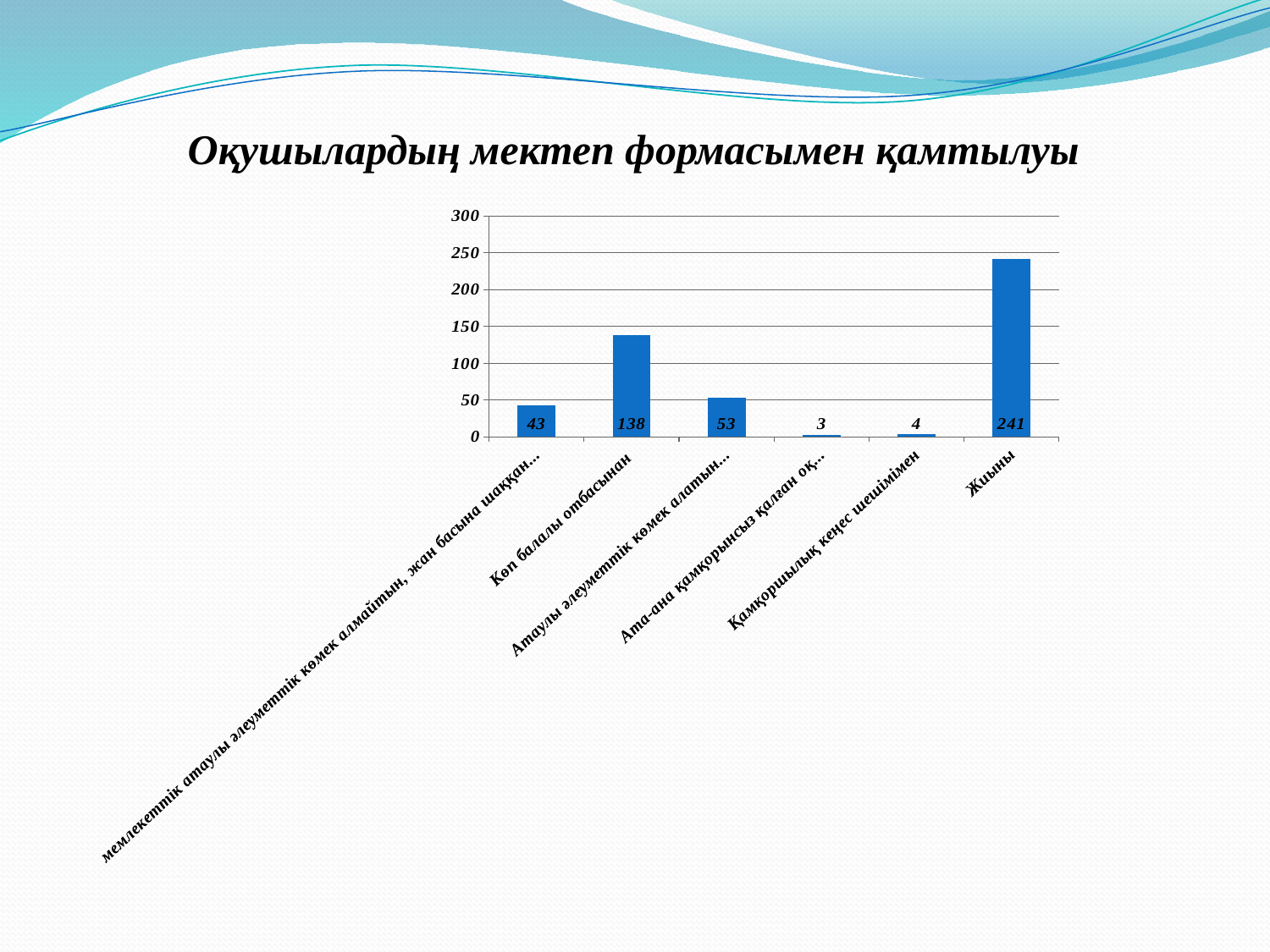
What kind of chart is shown on the slide? bar chart Which category has the lowest value? Ата-ана қамқорынсыз қалған оқ... What is the difference between the values for "Көп балалы отбасынан" and the category beginning "Атаулы әлеуметтік көмек алатын"? 85 What is the value for the category "Жиыны"? 241 What is the title of the slide? Оқушылардың мектеп формасымен қамтылуы What is the value for the category "Қамқоршылық кеңес шешімімен"? 4 Is the value for "Жиыны" greater or less than 200? greater How many categories are shown on the x axis? 6 What is the value for the category whose label begins "Атаулы әлеуметтік көмек алатын"? 53 Which is larger: the value for "Көп балалы отбасынан" or the value for the category beginning "мемлекеттік атаулы әлеуметтік көмек алмайтын"? Көп балалы отбасынан What is the value for the category "Көп балалы отбасынан"? 138 Which category has the highest value? Жиыны